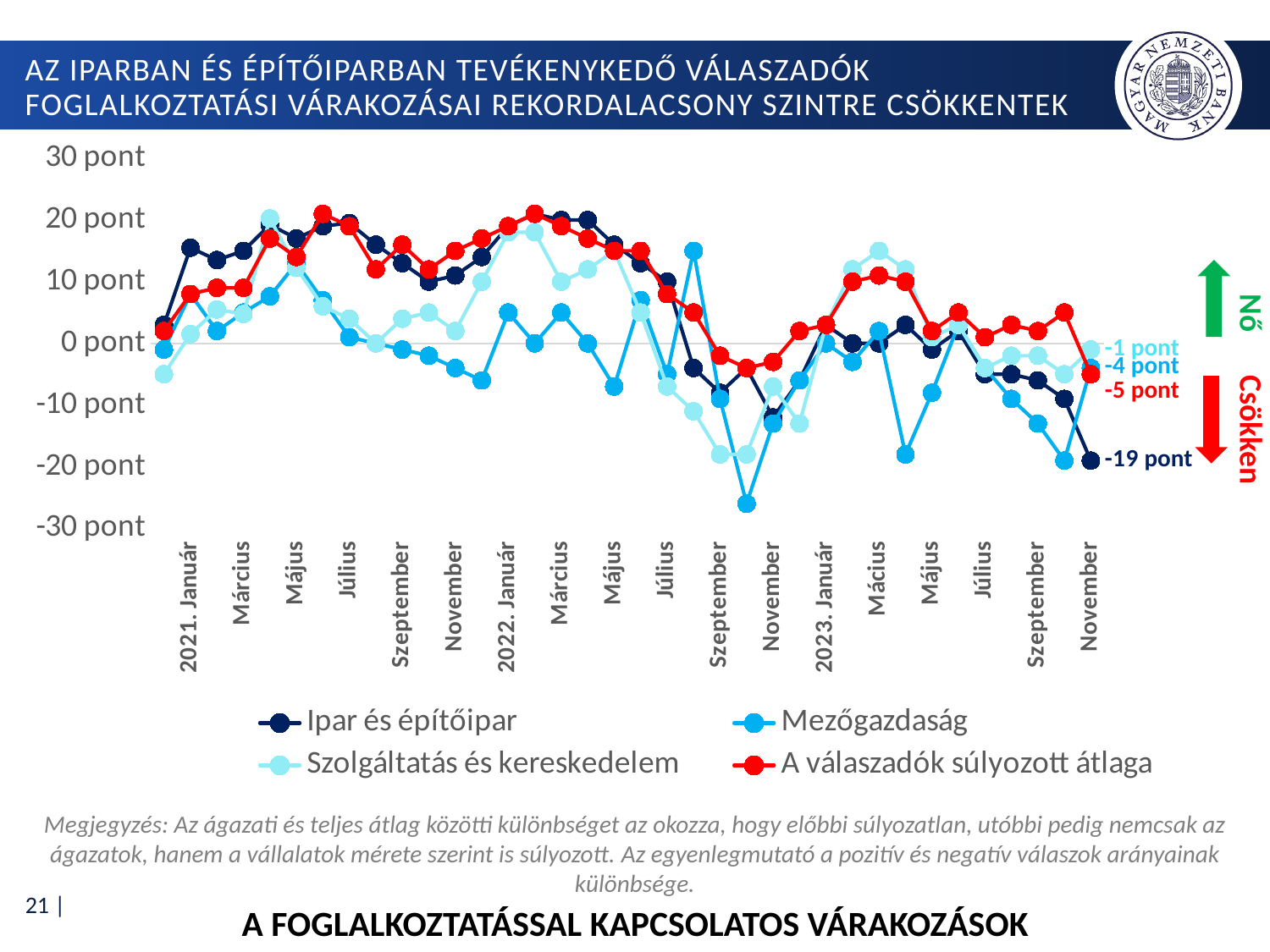
Is the value for Mezőgazdaság in September 2022 greater or less than -20 pont? greater Does the Ipar és építőipar line rise or fall between May 2023 and November 2023? Falls What is the value for Ipar és építőipar in November 2023, as labelled at the end of the line? -19 pont What is the value for A válaszadók súlyozott átlaga in November 2023, as labelled at the end of the line? -5 pont Which series is drawn in red? A válaszadók súlyozott átlaga How many series does the legend list? 4 In November 2023, which is lower: Ipar és építőipar or Mezőgazdaság? Ipar és építőipar What kind of chart is shown on the slide? Line chart Which series has the lowest value in November 2023? Ipar és építőipar What is the value for Mezőgazdaság in November 2023, as labelled at the end of the line? -4 pont What is the difference between the November 2023 values of A válaszadók súlyozott átlaga (-5 pont) and Ipar és építőipar (-19 pont)? 14 pont What is the value for Szolgáltatás és kereskedelem in November 2023, as labelled at the end of the line? -1 pont